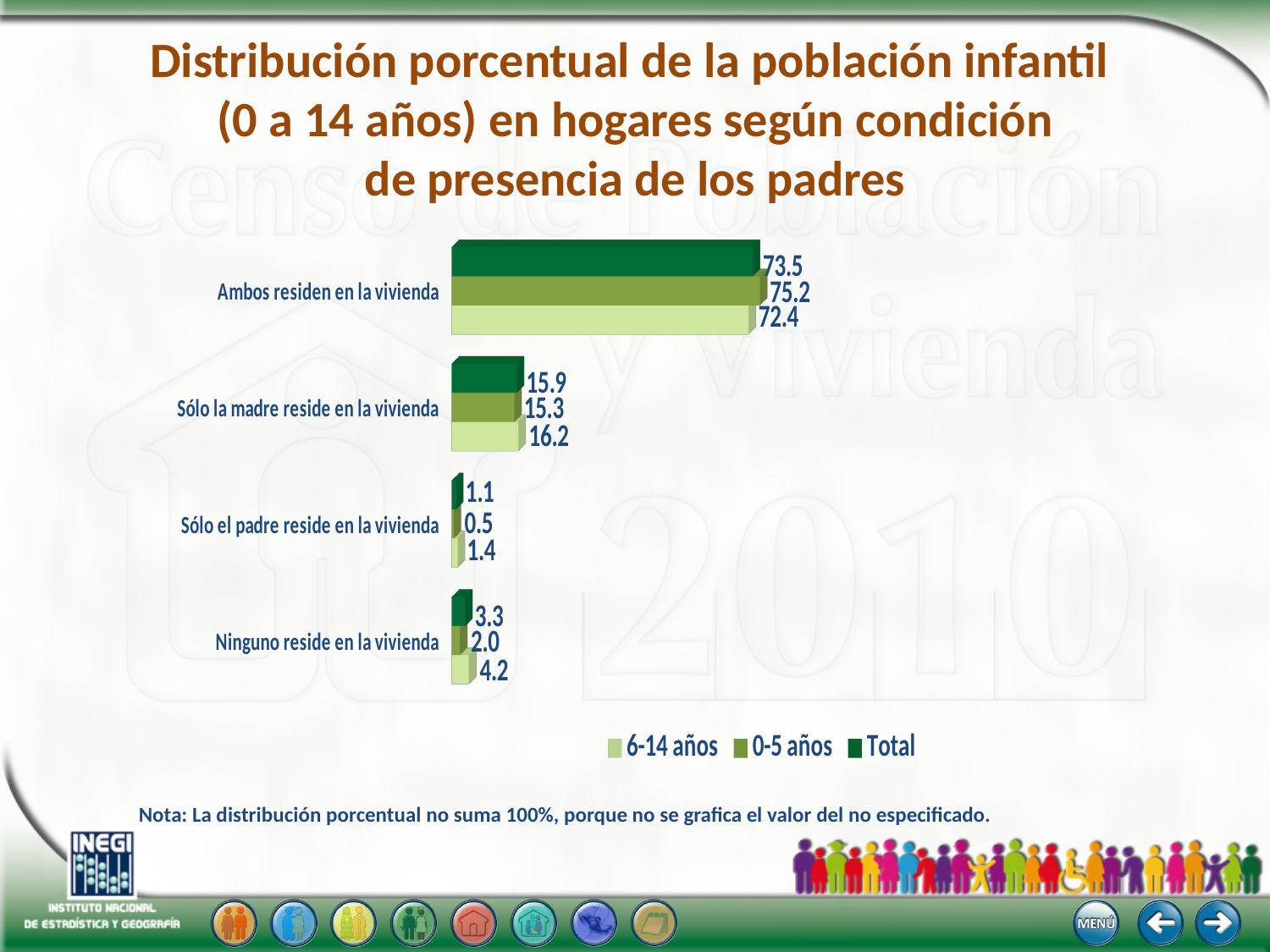
What kind of chart is shown on the slide? Bar chart What is the value for '6-14 años' in the category 'Ninguno reside en la vivienda'? 4.2 Which series is shown in the darkest green colour in the legend? Total What is the value for '0-5 años' in the category 'Sólo la madre reside en la vivienda'? 15.3 What is the Total value for 'Ambos residen en la vivienda'? 73.5 Which category has the lowest value for '6-14 años'? Sólo el padre reside en la vivienda How many series does the legend list? 3 Which category has the highest Total value? Ambos residen en la vivienda What is the value for '0-5 años' in the category 'Sólo el padre reside en la vivienda'? 0.5 For 'Ninguno reside en la vivienda', which is larger: the '0-5 años' value or the '6-14 años' value? 6-14 años What is the difference between the '0-5 años' and '6-14 años' values for 'Ambos residen en la vivienda'? 2.8 How many categories are shown on the chart? 4